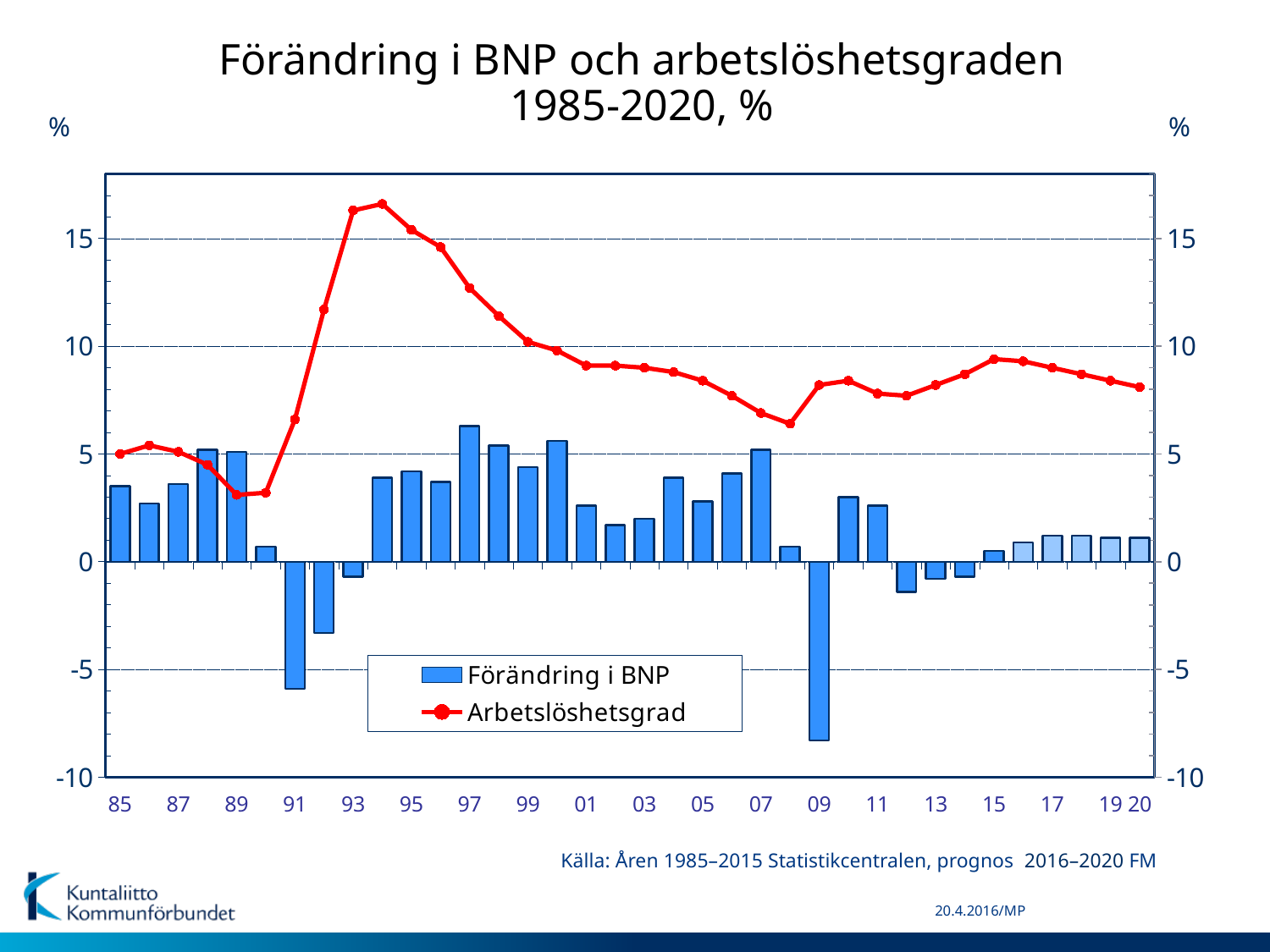
Is the Förändring i BNP value for 2009 greater or less than -5? less How many series does the legend list? 2 In which year does the Arbetslöshetsgrad line reach its highest value? 1994 Is the Arbetslöshetsgrad value for 2008 greater or less than 10? less In which year is the Förändring i BNP bar lowest? 2009 Is the Arbetslöshetsgrad value for 1994 greater or less than 15? greater Which year has the lower Förändring i BNP value, 1991 or 2009? 2009 Which series is shown as blue bars? Förändring i BNP What kind of chart is shown on the slide? A combined bar and line chart Does the Arbetslöshetsgrad line rise or fall between 1990 and 1994? rise Which series is drawn as a red line with markers? Arbetslöshetsgrad Does the Arbetslöshetsgrad line rise or fall between 1994 and 2008? fall